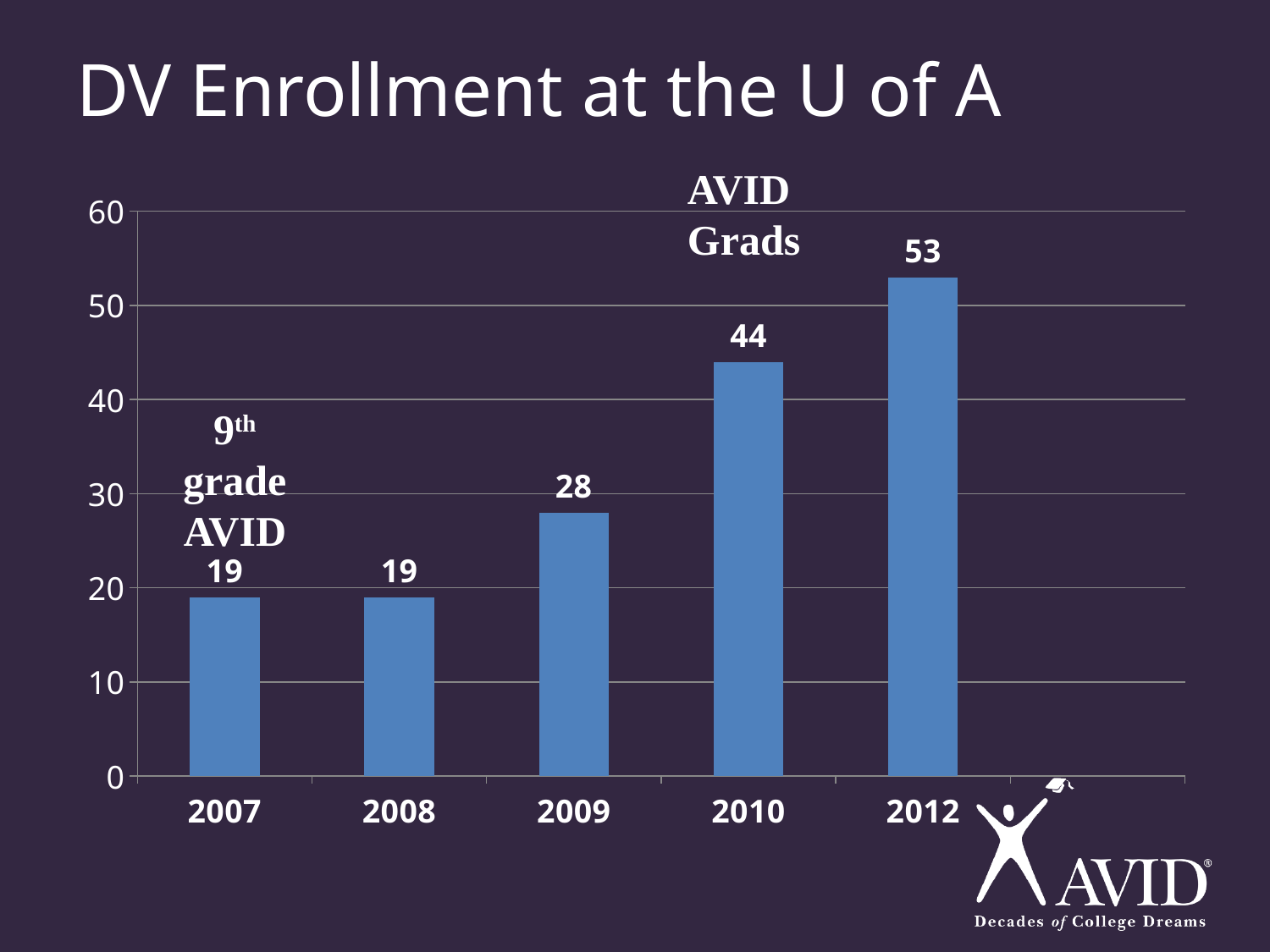
What is the value for 2012? 53 Do the values generally rise or fall from 2007 to 2012? rise Which year has the highest value? 2012 What is the title of the chart? DV Enrollment at the U of A How many years are shown on the x axis? 5 Is the value for 2010 greater or less than 40? greater What is the difference between the values for 2012 and 2010? 9 What is the difference between the values for 2009 and 2008? 9 What is the value for 2007? 19 Which is larger, the value for 2010 or the value for 2009? 2010 What kind of chart is shown on the slide? bar chart What is the value for 2009? 28